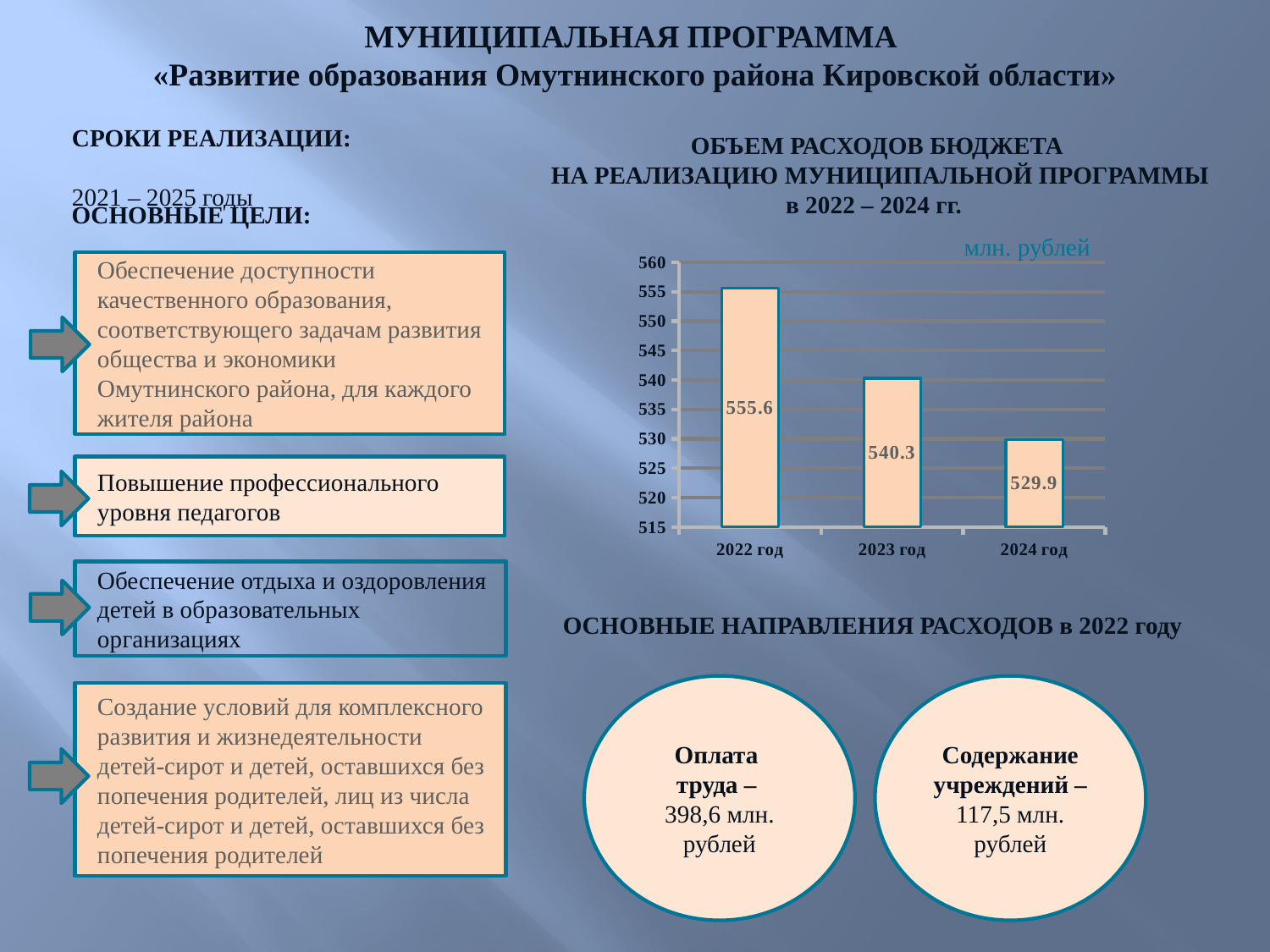
Do the values rise or fall from 2022 год to 2024 год? fall What is the value for 2024 год in the bar chart? 529.9 Which is larger, the value for 2023 год or the value for 2024 год? 2023 год Which year has the highest value in the bar chart? 2022 год How many bars are shown in the chart? 3 What is the difference between the values for 2022 год and 2023 год? 15.3 What is the difference between the values for 2023 год and 2024 год? 10.4 What is the value for 2022 год in the bar chart? 555.6 Which year has the lowest value in the bar chart? 2024 год What is the difference between the values for 2022 год and 2024 год? 25.7 What is the value for 2023 год in the bar chart? 540.3 What type of chart is shown on the slide? bar chart